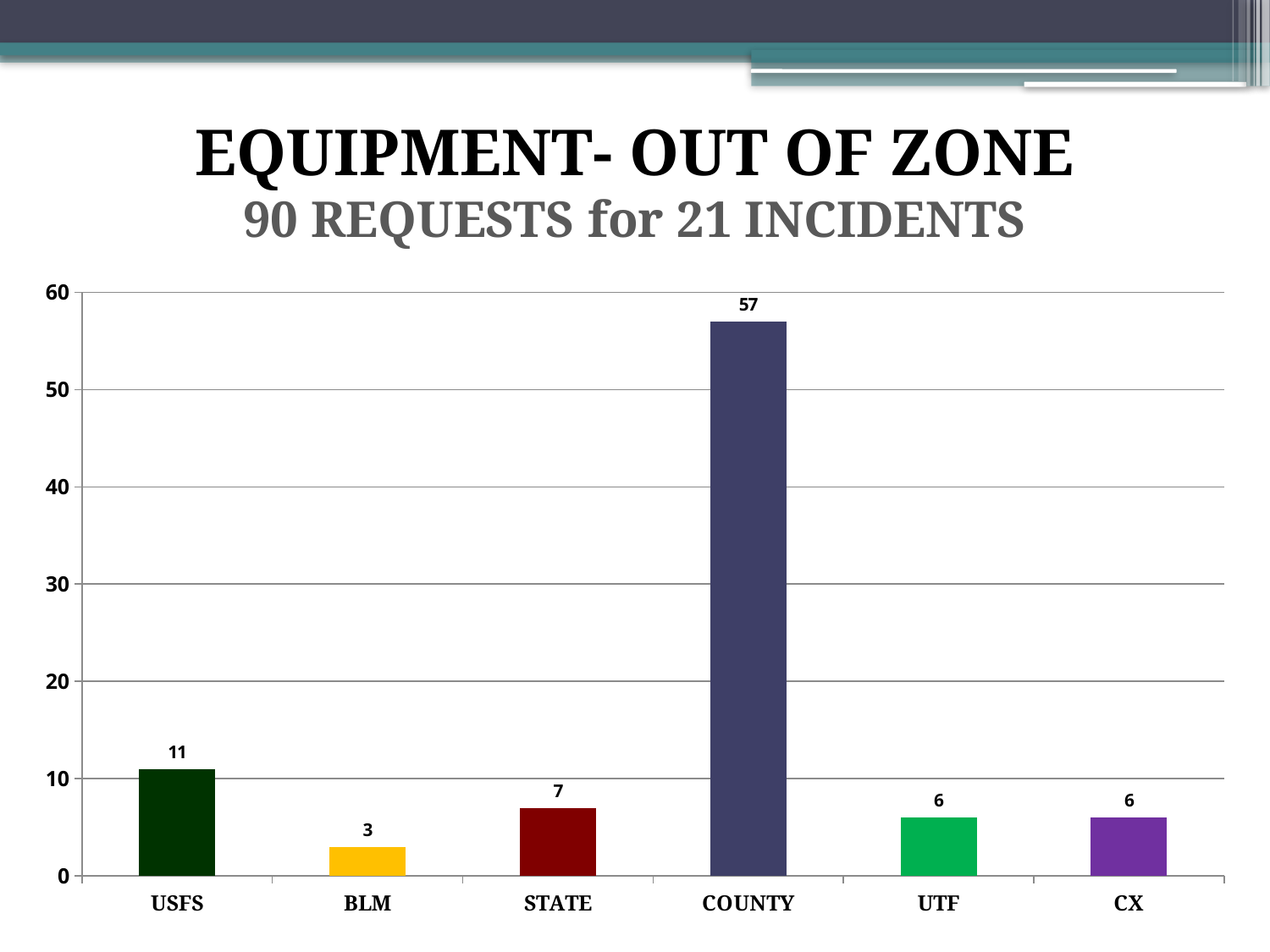
Is the value for COUNTY greater or less than 50? greater What is the difference between the values for STATE and BLM? 4 What is the value for STATE? 7 Which is larger, the value for USFS or the value for STATE? USFS How many categories are shown on the x axis? 6 Which category has the lowest value? BLM What kind of chart is shown on the slide? bar chart Which category has the highest value? COUNTY What is the value for COUNTY? 57 What is the value for BLM? 3 What is the difference between the values for COUNTY and USFS? 46 What is the value for USFS? 11